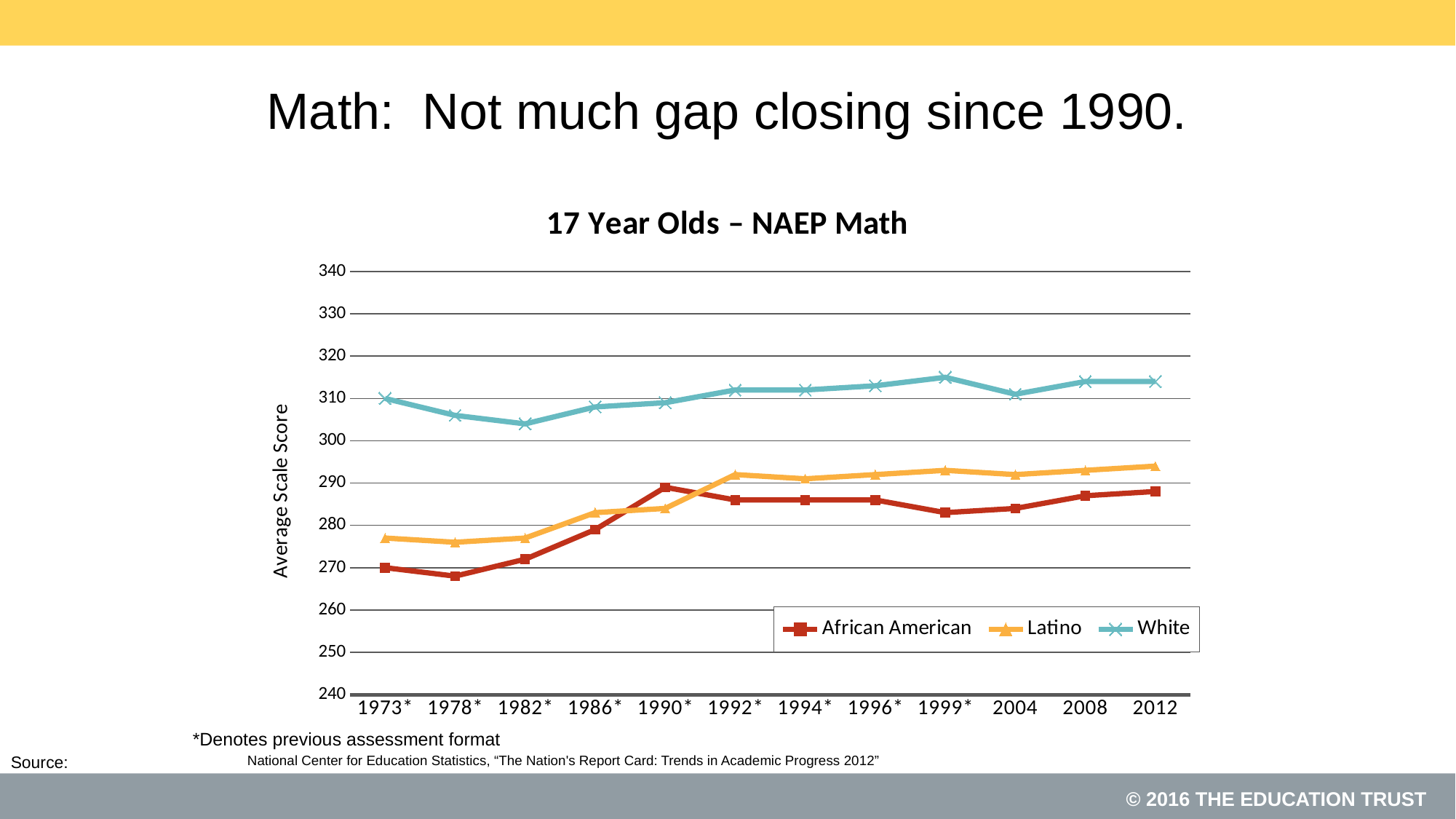
Is the African American score in 1990* greater or less than 280? greater Which group had the highest average scale score in 2012? White What type of chart is shown on the slide? line chart Did the White score rise or fall from 1973* to 1982*? fall Is the Latino score in 2012 greater or less than 300? less How many assessment years are plotted along the x axis? 12 What is the title of the chart? 17 Year Olds – NAEP Math In 1990*, which was larger, the African American score or the Latino score? African American Which group had the lowest average scale score in 1973*? African American What is the y-axis label of the chart? Average Scale Score How many series does the legend list? 3 Is the White score in 1982* greater or less than 310? less